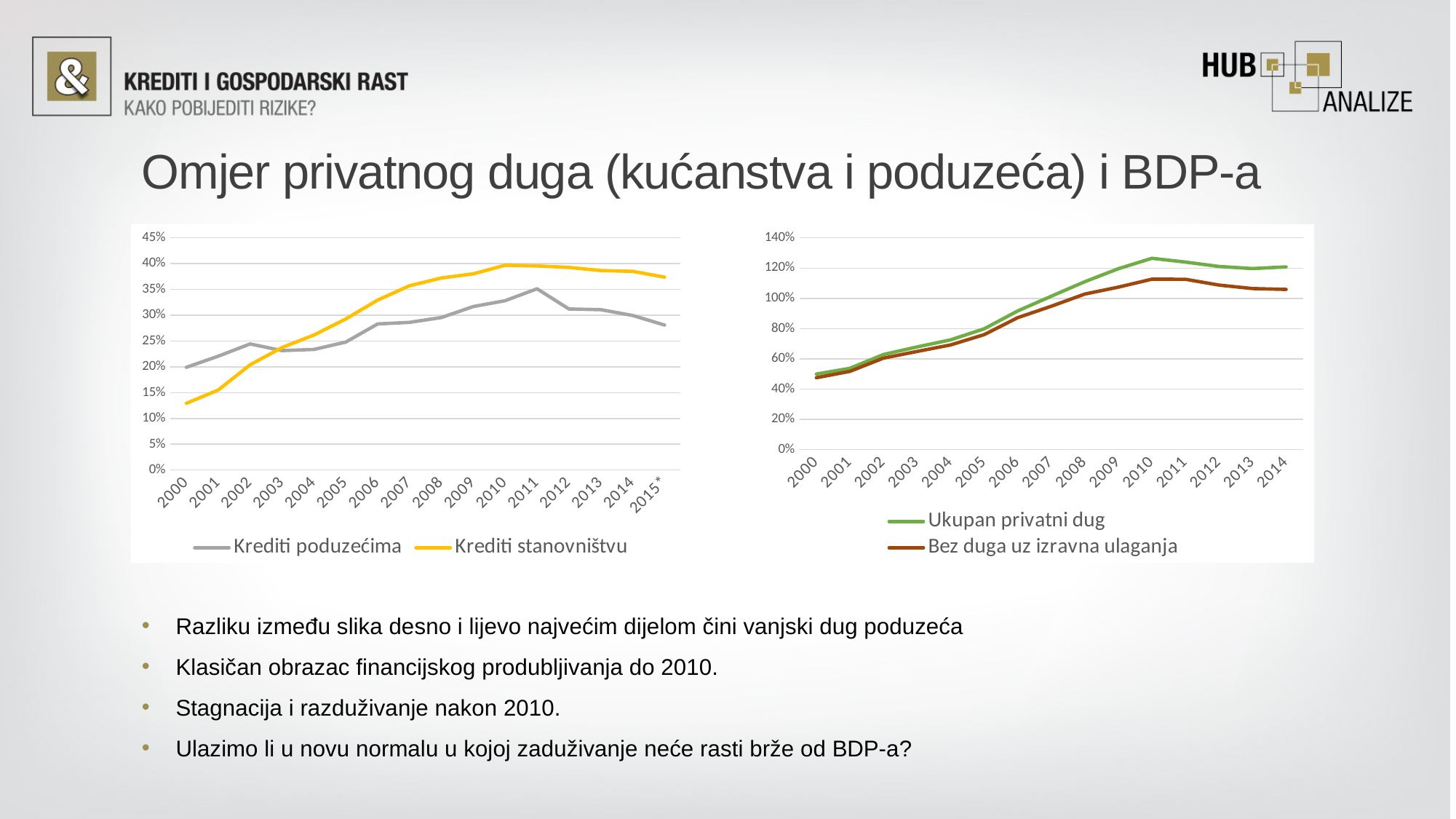
How many series does the legend of the right chart list? 2 How many years are shown on the x axis of the right chart? 15 In the right chart, in which year does Ukupan privatni dug reach its highest value? 2010 In the right chart, is the value for Ukupan privatni dug in 2010 greater or less than 120%? greater In the left chart, which series has the larger value in 2015*, Krediti poduzećima or Krediti stanovništvu? Krediti stanovništvu How many years are shown on the x axis of the left chart? 16 In the left chart, in which year does Krediti poduzećima reach its highest value? 2011 In the left chart, is the value for Krediti stanovništvu in 2000 greater or less than 15%? less What kind of chart is the left chart on the slide? line chart In the left chart, which series has the larger value in 2000, Krediti poduzećima or Krediti stanovništvu? Krediti poduzećima In the right chart, does Ukupan privatni dug rise or fall between 2000 and 2010? rise